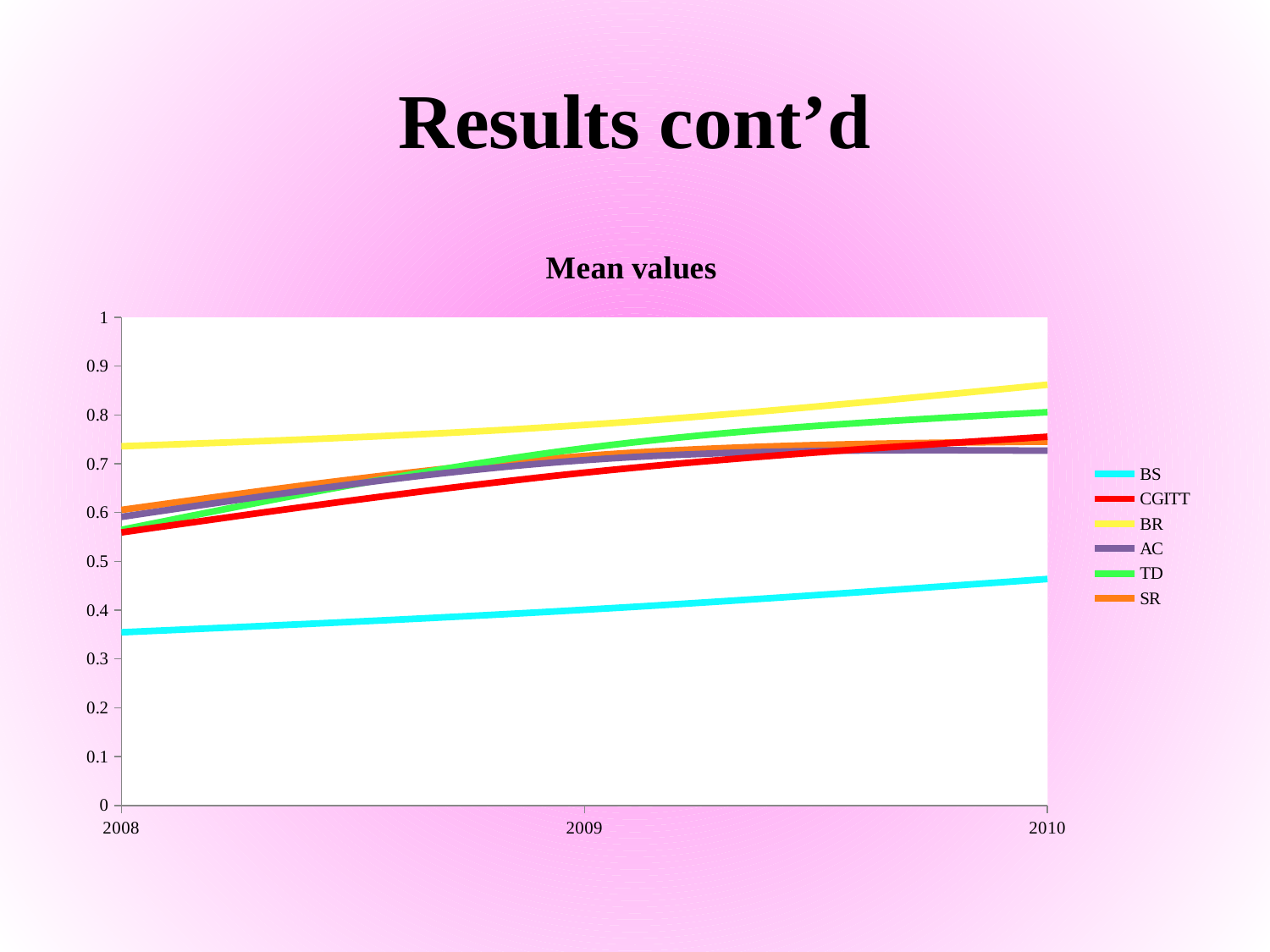
What kind of chart is shown on the slide? Line chart Which series has the lowest value in 2010? BS Which is larger in 2009, the value for BR or the value for BS? BR Is the value for BS in 2008 greater or less than 0.4? less Is the value for BS in 2010 greater or less than 0.5? less Which series has the lowest value in 2008? BS Which series has the highest value in 2010? BR How many series does the legend list? 6 Is the value for BR in 2010 greater or less than 0.8? greater What is the title of the chart? Mean values Does the BS series rise or fall from 2008 to 2010? Rises How many years are shown on the x axis? 3